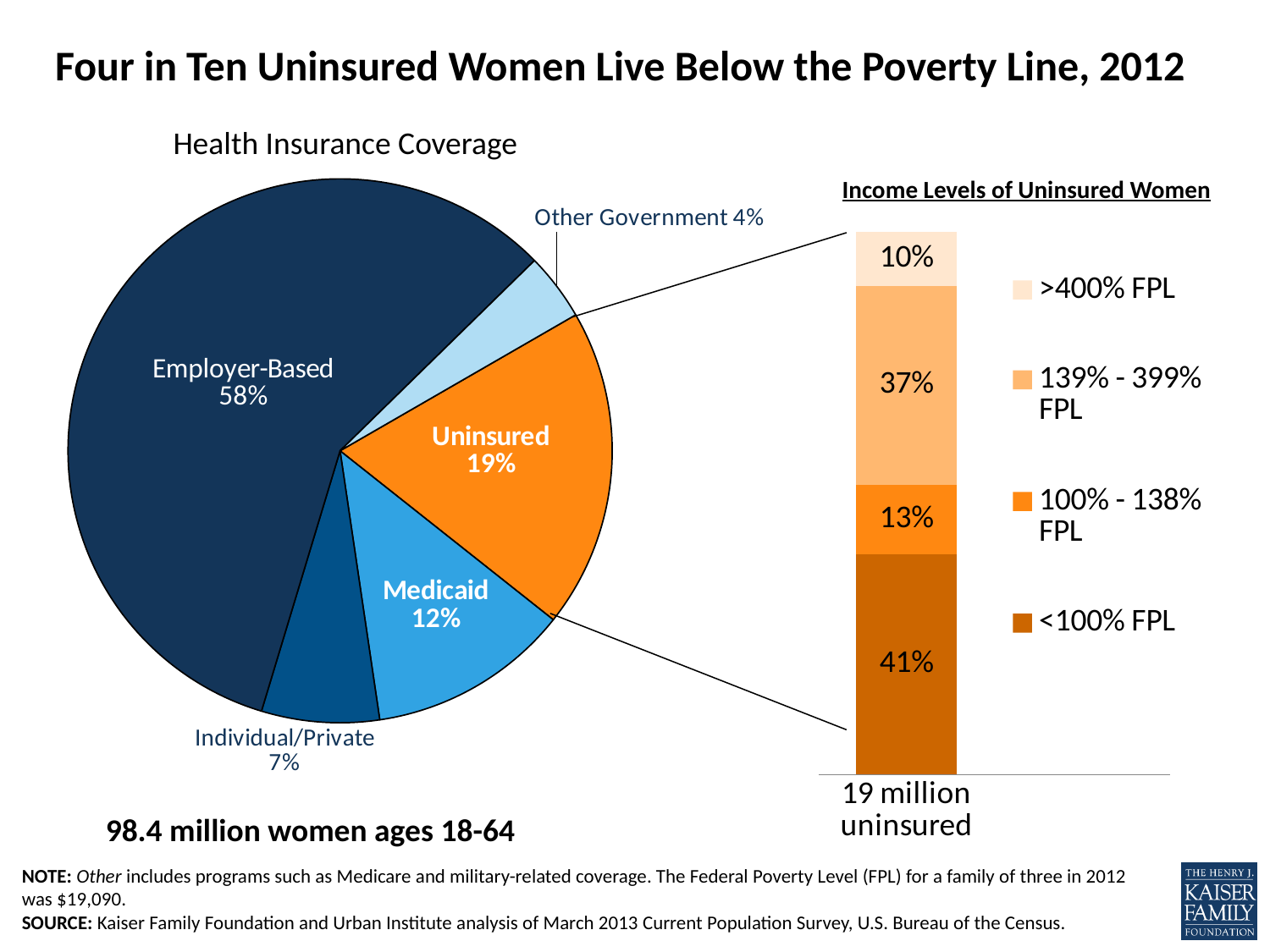
In the Health Insurance Coverage pie chart, how many slices are there? 5 In the Health Insurance Coverage pie chart, which category has the largest share? Employer-Based In the Income Levels of Uninsured Women chart, what percentage of uninsured women are at 139% - 399% FPL? 37% In the Health Insurance Coverage pie chart, what percentage of women are Uninsured? 19% In the Health Insurance Coverage pie chart, which is larger, Medicaid or Uninsured? Uninsured In the Health Insurance Coverage pie chart, what is the difference between the Medicaid share and the Individual/Private share? 5% What kind of chart is the Health Insurance Coverage chart? Pie chart In the Income Levels of Uninsured Women chart, which income level has the smallest share? >400% FPL In the Health Insurance Coverage pie chart, what share of women are Employer-Based? 58% In the Income Levels of Uninsured Women chart, how many income levels does the legend list? 4 In the Income Levels of Uninsured Women chart, what percentage of uninsured women are below 100% FPL? 41% In the Health Insurance Coverage pie chart, which category has the smallest share? Other Government